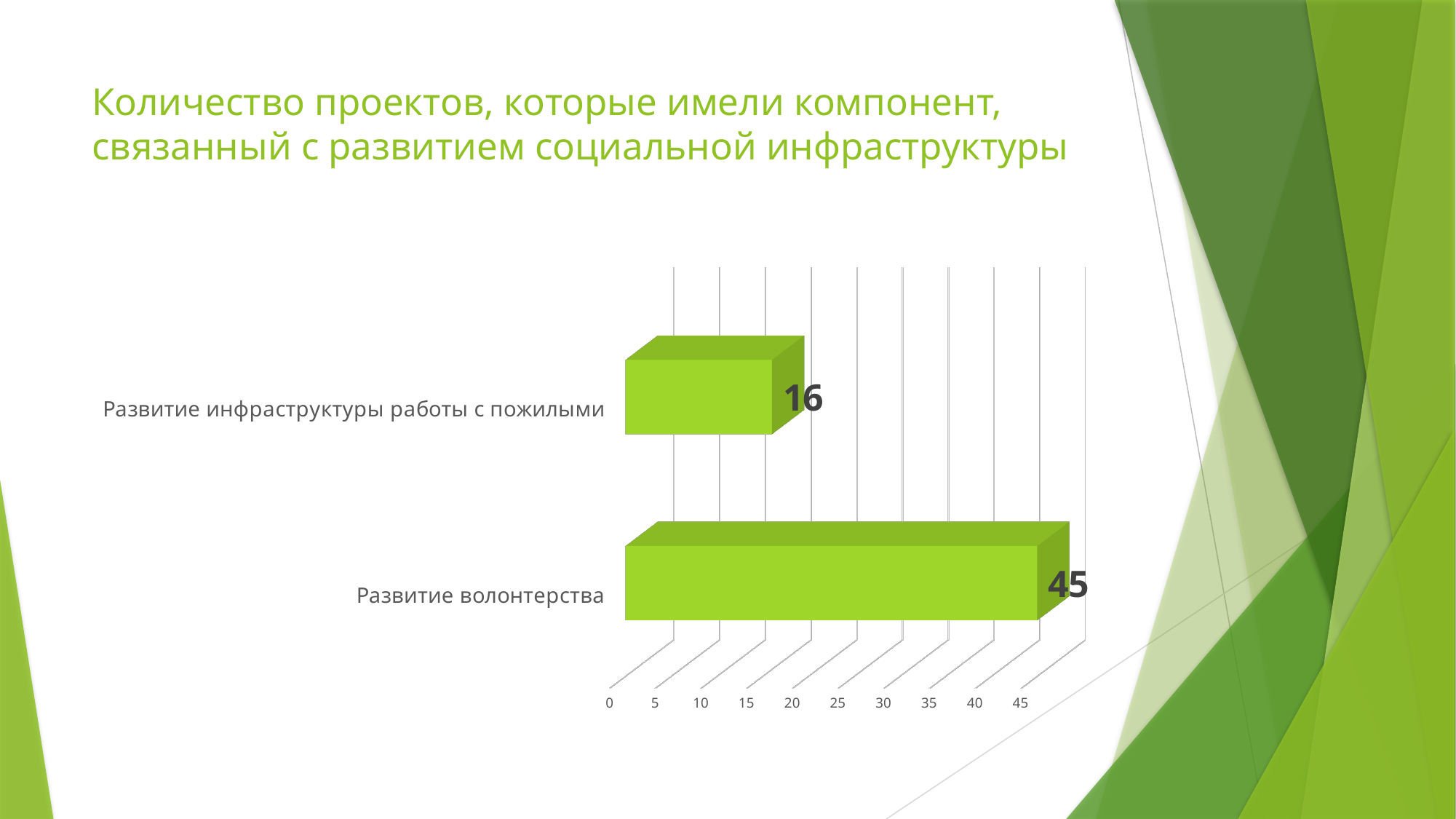
What is the highest tick value shown on the value axis? 45 Which is larger: the value for Развитие волонтерства or the value for Развитие инфраструктуры работы с пожилыми? Развитие волонтерства Is the value for Развитие волонтерства greater or less than 40? greater What is the title of the slide? Количество проектов, которые имели компонент, связанный с развитием социальной инфраструктуры What kind of chart is shown on the slide? bar chart What is the difference between the values for Развитие волонтерства and Развитие инфраструктуры работы с пожилыми? 29 Is the value for Развитие инфраструктуры работы с пожилыми greater or less than 20? less Which category has the lowest value? Развитие инфраструктуры работы с пожилыми What is the value for Развитие инфраструктуры работы с пожилыми? 16 What is the value for Развитие волонтерства? 45 Which category has the highest value? Развитие волонтерства How many categories are shown in the chart? 2